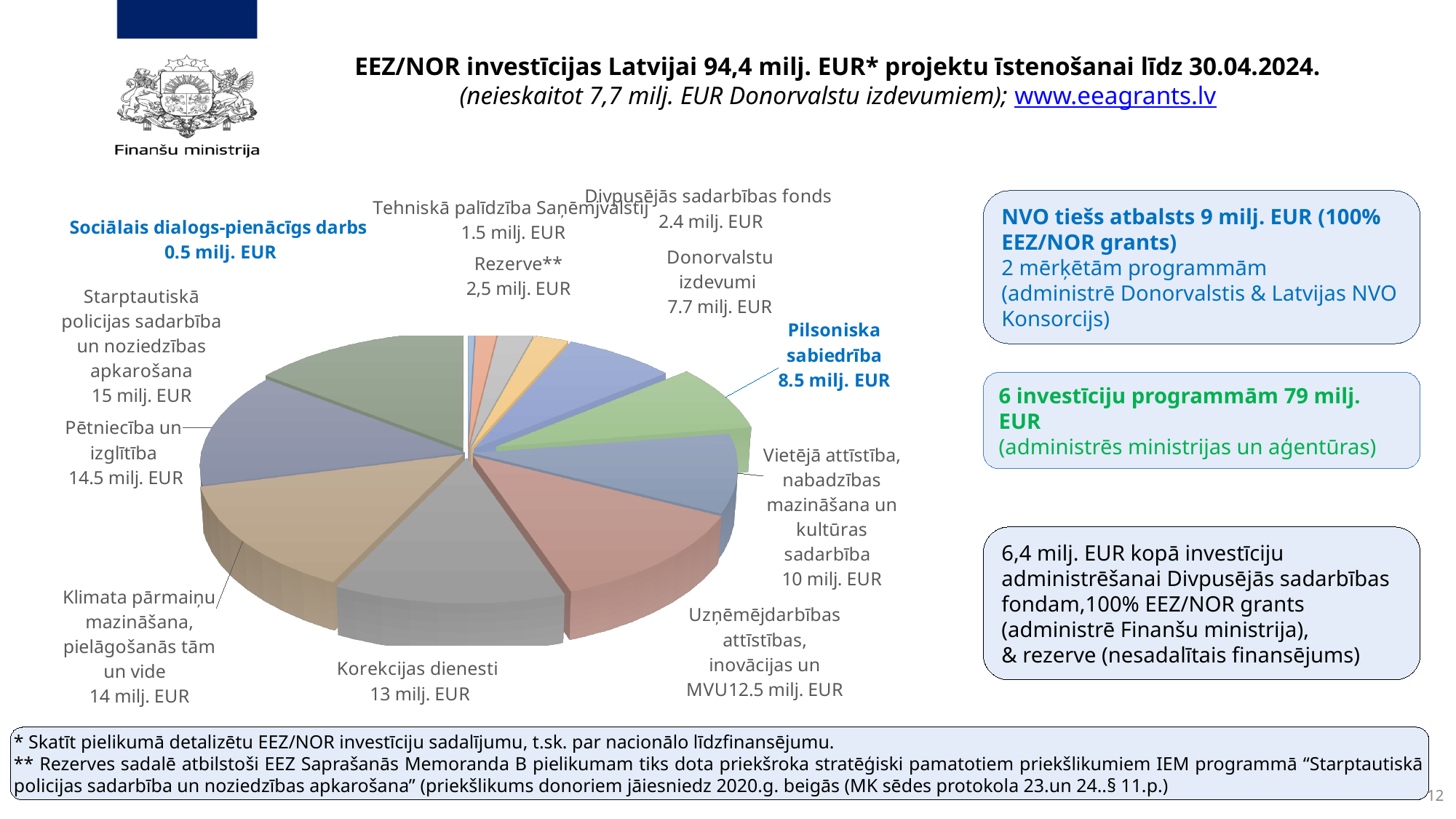
What is the value for Korekcijas dienesti in the pie chart? 13 milj. EUR Which category has the smallest value in the pie chart? Sociālais dialogs-pienācīgs darbs What is the value for Divpusējās sadarbības fonds in the pie chart? 2.4 milj. EUR How many categories (slices) does the pie chart have? 12 What is the difference between the values for Starptautiskā policijas sadarbība un noziedzības apkarošana and Pētniecība un izglītība? 0.5 milj. EUR What kind of chart is shown on the slide? Pie chart Which is larger: the value for Donorvalstu izdevumi or the value for Pilsoniska sabiedrība? Pilsoniska sabiedrība What is the value for Rezerve** in the pie chart? 2,5 milj. EUR Which category has the largest value in the pie chart? Starptautiskā policijas sadarbība un noziedzības apkarošana What is the difference between the values for Vietējā attīstība, nabadzības mazināšana un kultūras sadarbība and Pilsoniska sabiedrība? 1.5 milj. EUR Which is larger: the value for Korekcijas dienesti or the value for Uzņēmējdarbības attīstības, inovācijas un MVU? Korekcijas dienesti What is the value for Pilsoniska sabiedrība in the pie chart? 8.5 milj. EUR